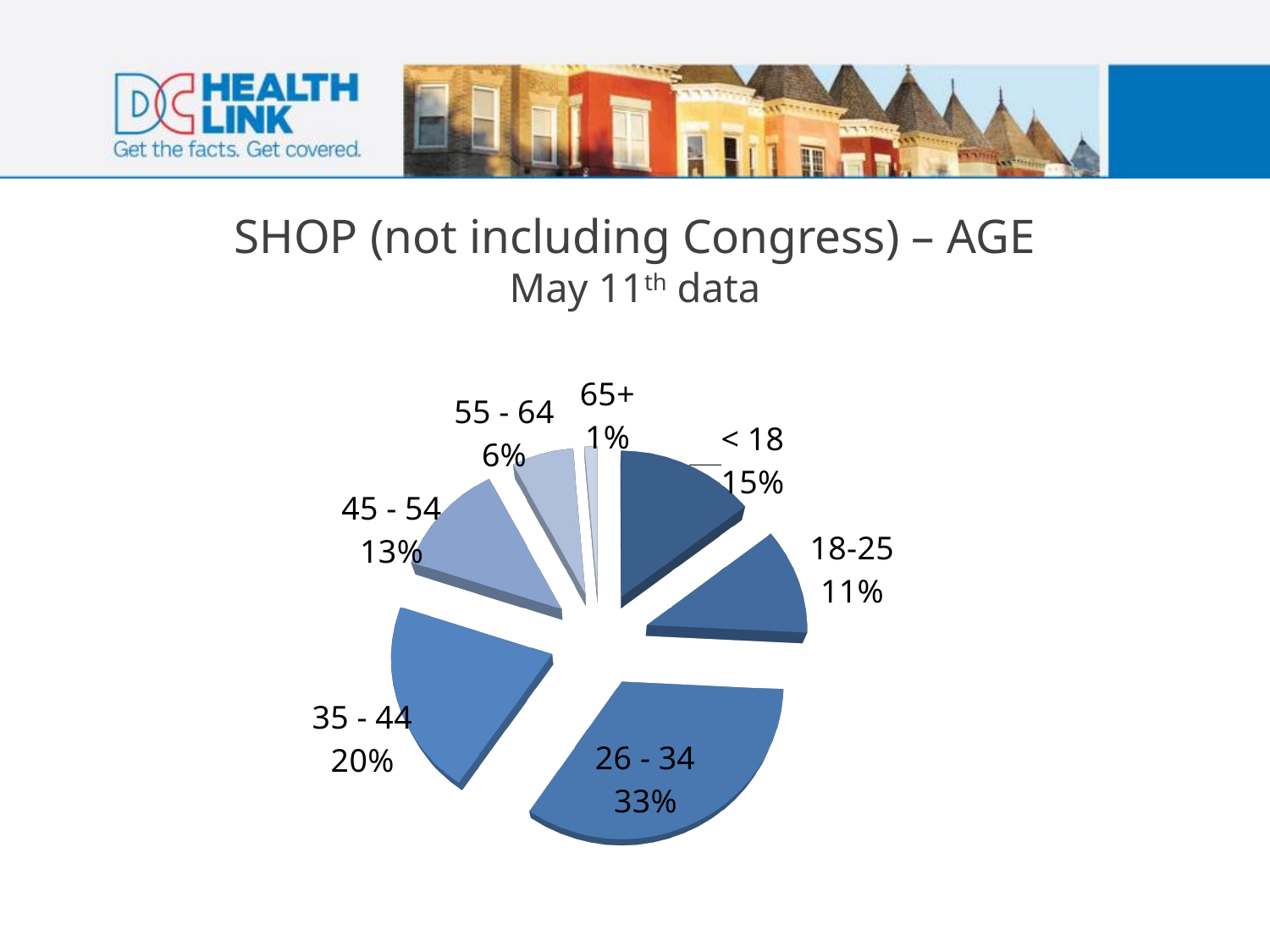
What kind of chart is shown on the slide? Pie chart What is the combined percentage of the 18-25 and 26 - 34 age groups? 44% What share of the pie does the 26 - 34 age group have? 33% What percentage is shown for the 45 - 54 age group? 13% What percentage is shown for the < 18 age group? 15% How many age groups are shown in the pie chart? 7 Which age group has a larger share, 55 - 64 or 45 - 54? 45 - 54 What percentage is shown for the 65+ age group? 1% Which age group has the smallest share of the pie? 65+ What is the difference in percentage points between the 35 - 44 and 18-25 age groups? 9 What is the title of the chart on the slide? SHOP (not including Congress) – AGE May 11th data Which age group has the largest share of the pie? 26 - 34